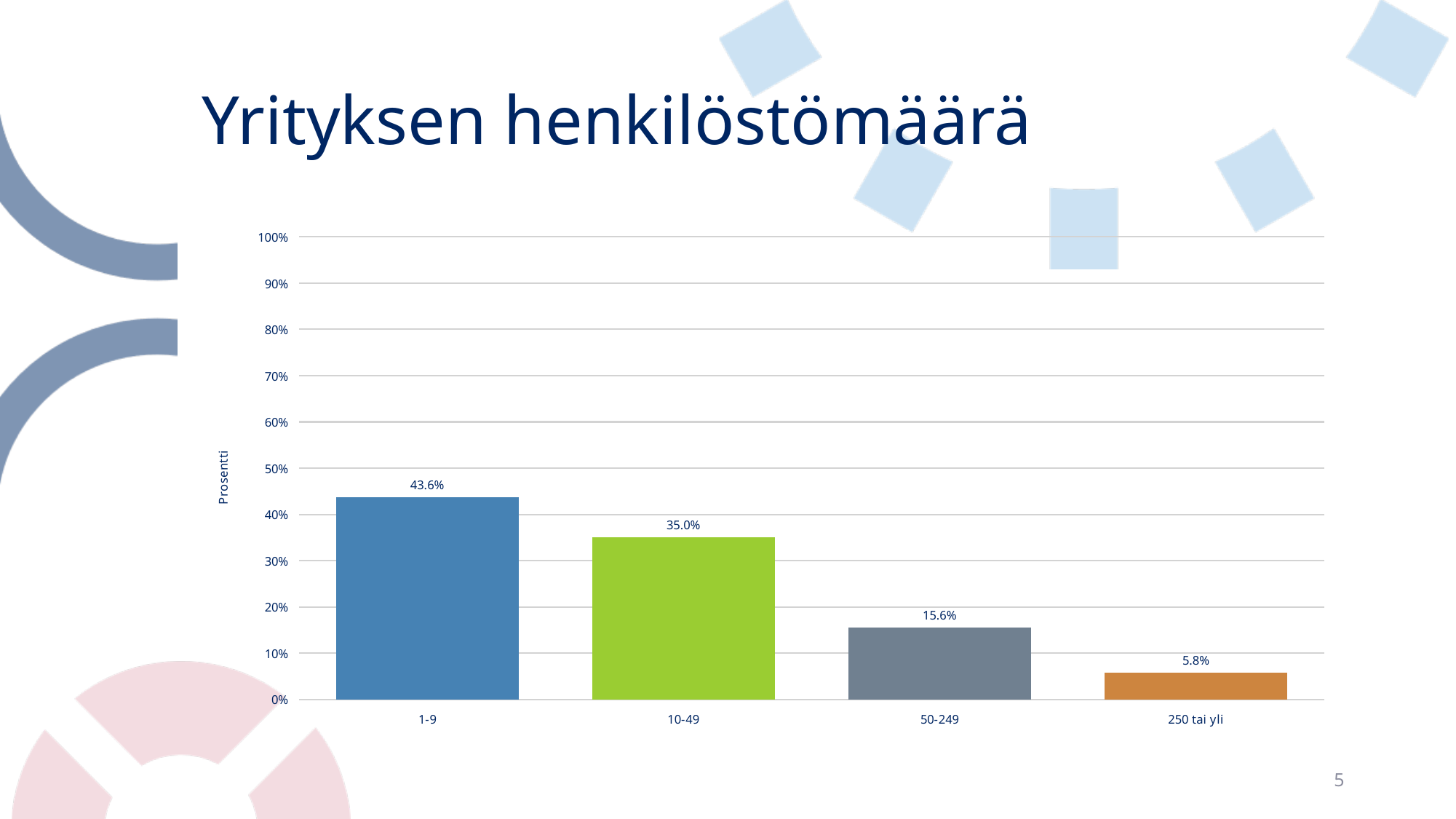
Is the value for 10-49 greater or less than 30%? greater What is the value for the 1-9 category? 43.6% What is the value for the 250 tai yli category? 5.8% How many categories are shown on the x axis? 4 What is the label of the y axis? Prosentti What is the value for the 10-49 category? 35.0% What is the difference between the values for 1-9 and 10-49? 8.6% Which category has the highest value? 1-9 What kind of chart is shown on the slide? bar chart Which category has the lowest value? 250 tai yli Which is larger, the value for 50-249 or the value for 250 tai yli? 50-249 What is the value for the 50-249 category? 15.6%